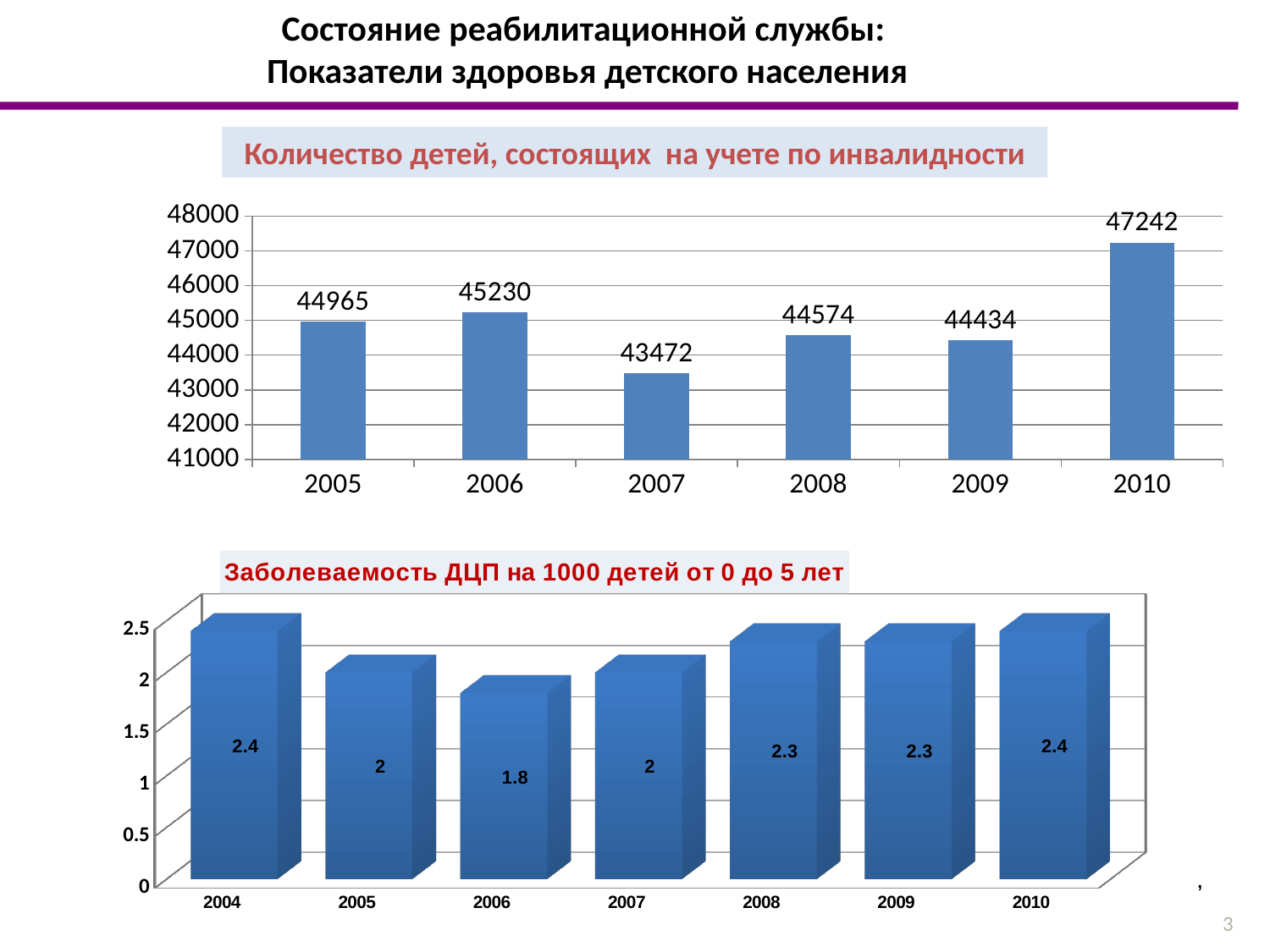
In the bottom chart 'Заболеваемость ДЦП на 1000 детей от 0 до 5 лет', what is the value for 2006? 1.8 In the bottom chart 'Заболеваемость ДЦП на 1000 детей от 0 до 5 лет', how many years are shown? 7 In the top chart 'Количество детей, состоящих на учете по инвалидности', what is the value for 2008? 44574 What type of chart is the bottom chart 'Заболеваемость ДЦП на 1000 детей от 0 до 5 лет'? Bar chart In the top chart 'Количество детей, состоящих на учете по инвалидности', which year has the lowest value? 2007 In the top chart 'Количество детей, состоящих на учете по инвалидности', which is larger, the value for 2005 or the value for 2006? 2006 In the bottom chart 'Заболеваемость ДЦП на 1000 детей от 0 до 5 лет', what is the difference between the values for 2008 and 2007? 0.3 In the top chart 'Количество детей, состоящих на учете по инвалидности', which year has the highest value? 2010 In the bottom chart 'Заболеваемость ДЦП на 1000 детей от 0 до 5 лет', which year has the lowest value? 2006 In the top chart 'Количество детей, состоящих на учете по инвалидности', what is the difference between the values for 2010 and 2009? 2808 In the top chart 'Количество детей, состоящих на учете по инвалидности', what is the value for 2007? 43472 In the top chart 'Количество детей, состоящих на учете по инвалидности', how many years are shown? 6